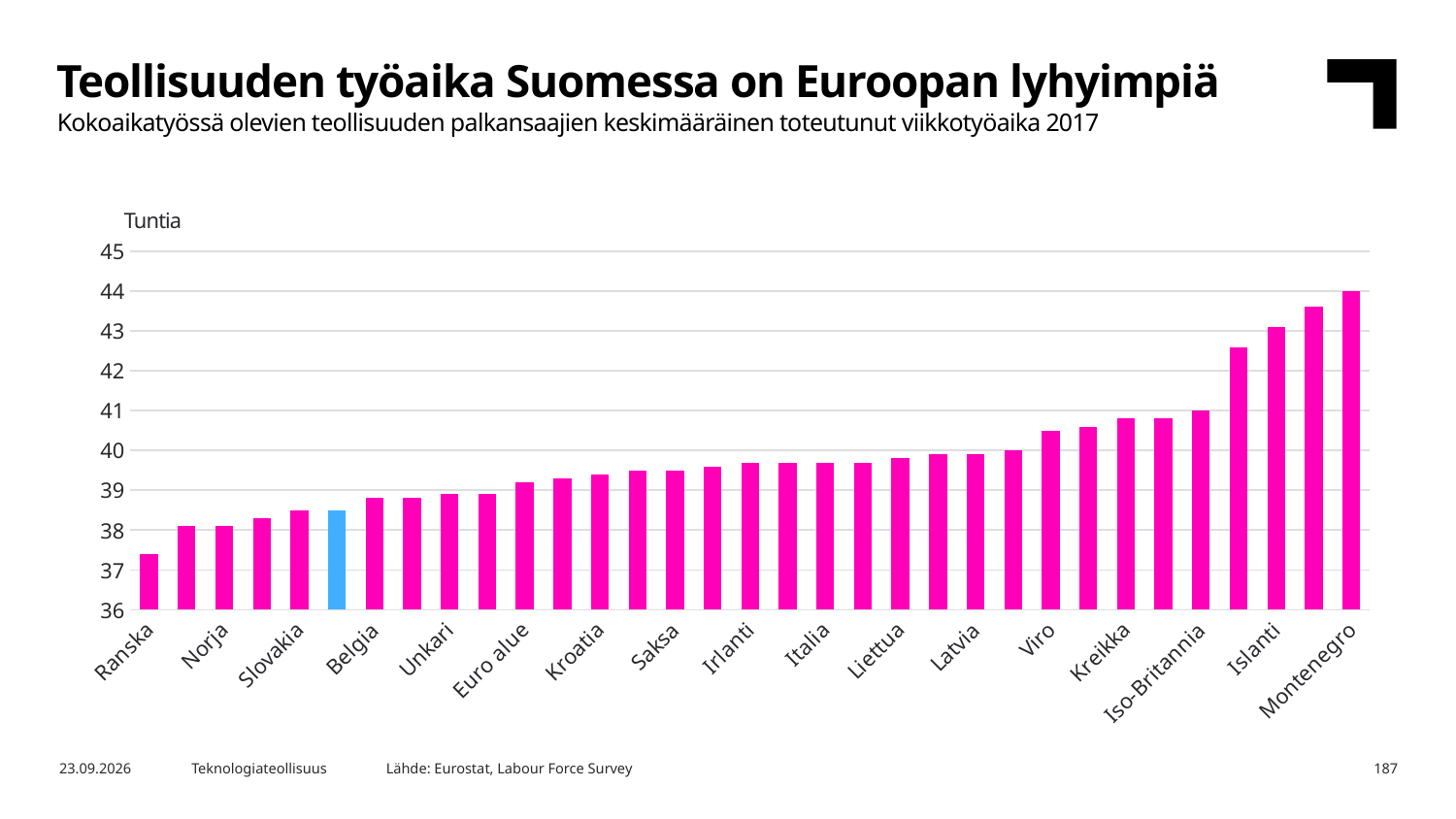
Which country has the lowest average weekly working time in the chart? Ranska Which has a higher value, Islanti or Viro? Islanti Is the value for Islanti greater or less than 42? greater Is the value for Saksa greater or less than 40? less Is the value for Kreikka greater or less than 40? greater What unit label is shown above the vertical axis? Tuntia Do the bar values rise or fall from left to right along the x axis? rise Which country has the highest average weekly working time in the chart? Montenegro Which has a higher value, Kreikka or Saksa? Kreikka What kind of chart is shown on the slide? bar chart